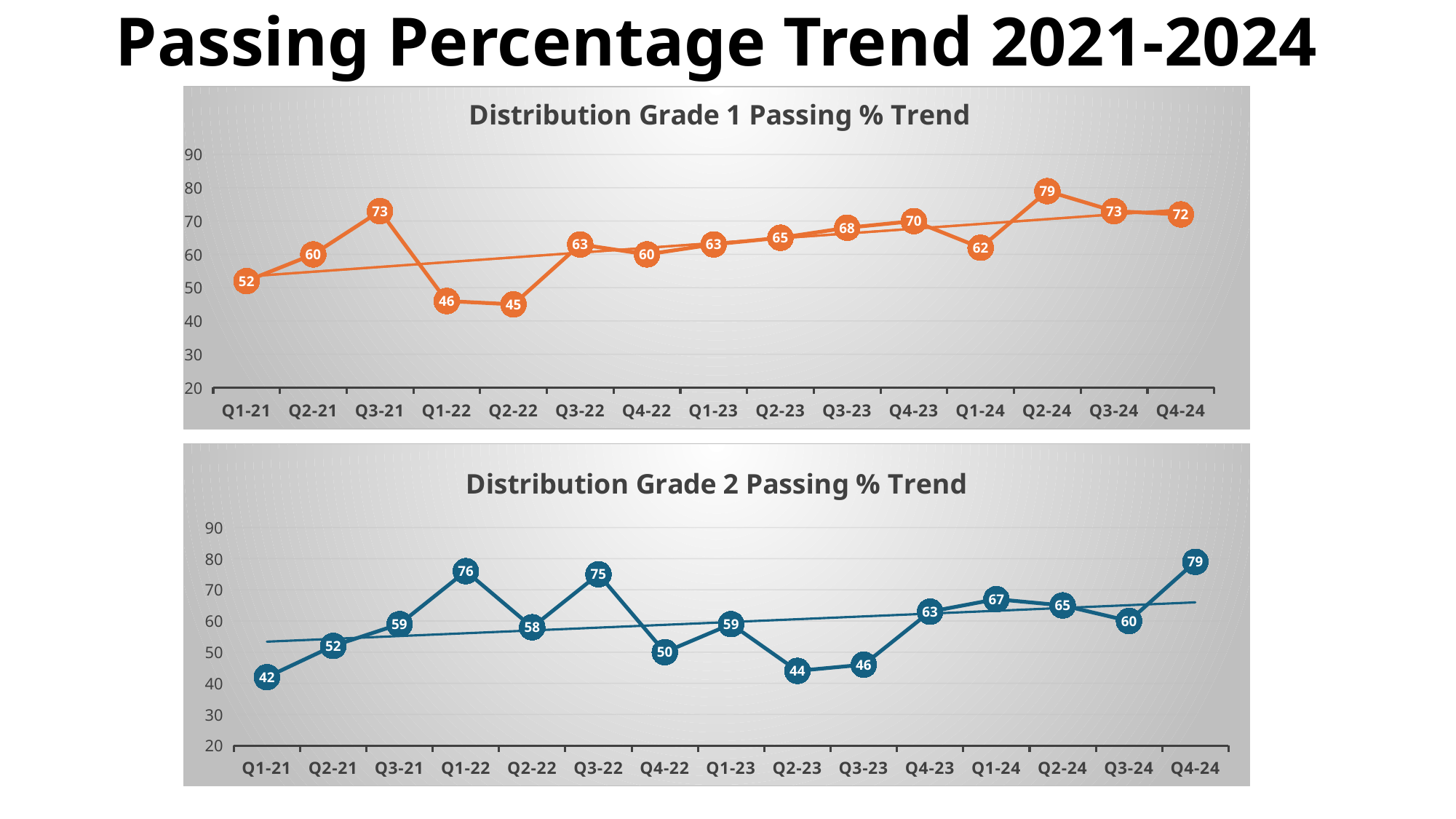
In the Distribution Grade 2 Passing % Trend chart, which quarter has the lowest value? Q1-21 In the Distribution Grade 1 Passing % Trend chart, how many quarters are plotted on the x axis? 15 In the Distribution Grade 2 Passing % Trend chart, what is the value for Q1-22? 76 In the Distribution Grade 1 Passing % Trend chart, which quarter has the lowest value? Q2-22 In the Distribution Grade 1 Passing % Trend chart, what is the difference between the values for Q2-24 and Q1-24? 17 In the Distribution Grade 2 Passing % Trend chart, which quarter has the highest value? Q4-24 In the Distribution Grade 2 Passing % Trend chart, which is larger, the value for Q3-22 or the value for Q4-22? Q3-22 In the Distribution Grade 2 Passing % Trend chart, what is the difference between the values for Q4-24 and Q3-24? 19 In the Distribution Grade 1 Passing % Trend chart, what is the value for Q3-21? 73 In the Distribution Grade 1 Passing % Trend chart, which quarter has the highest value? Q2-24 In the Distribution Grade 1 Passing % Trend chart, does the trend line rise or fall from Q1-21 to Q4-24? Rise What kind of chart is the Distribution Grade 2 Passing % Trend chart? Line chart